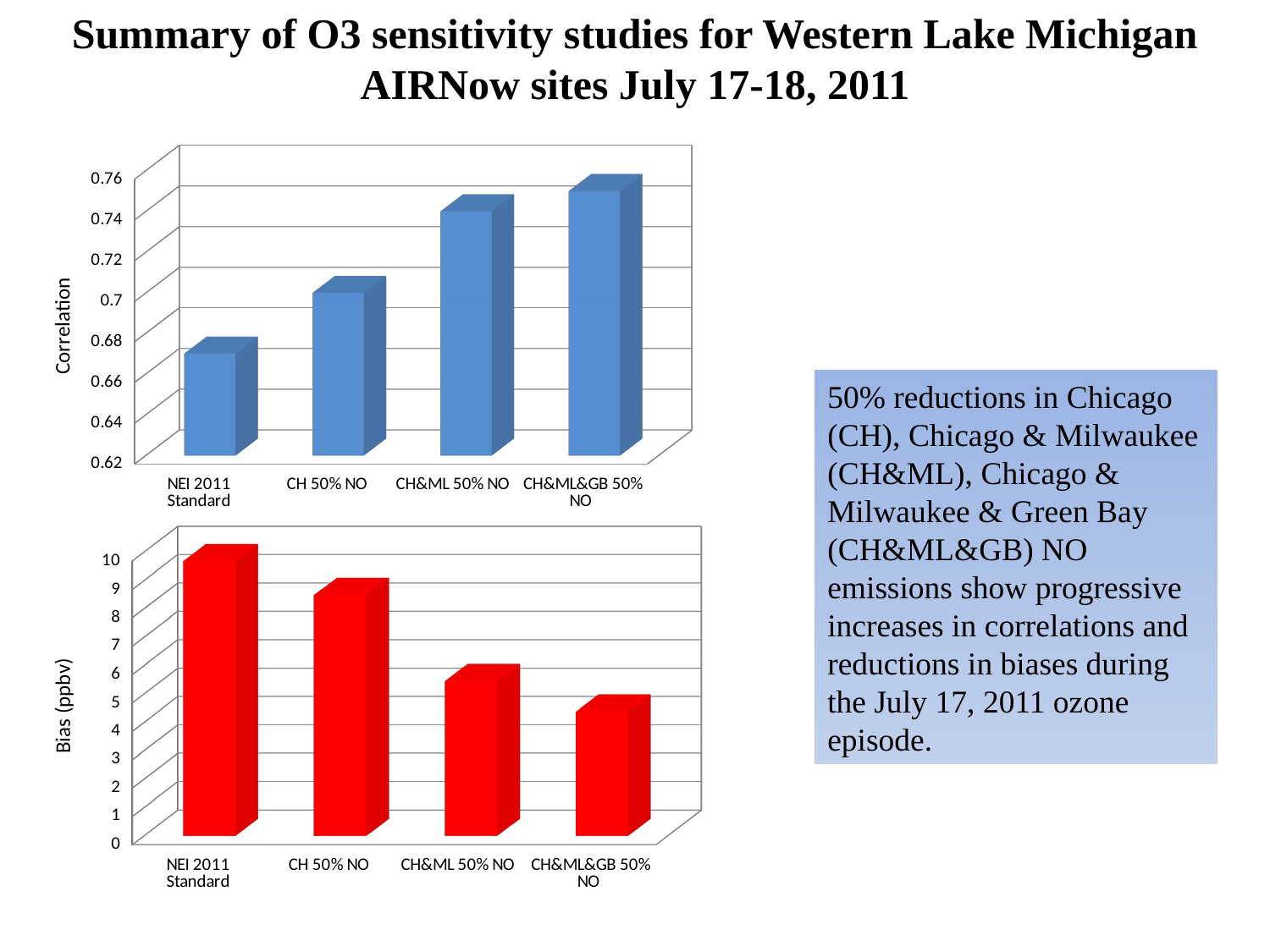
What kind of chart is the top chart with the Correlation axis? bar chart In the bottom Bias (ppbv) chart, which category has the lowest bias? CH&ML&GB 50% NO In the top Correlation chart, which category has the highest correlation? CH&ML&GB 50% NO In the bottom Bias (ppbv) chart, which is larger, the bias for CH 50% NO or for CH&ML 50% NO? CH 50% NO In the top Correlation chart, which category has the lowest correlation? NEI 2011 Standard In the top Correlation chart, how many categories are shown on the x axis? 4 In the top Correlation chart, is the value for CH&ML 50% NO greater or less than 0.72? greater In the bottom Bias (ppbv) chart, is the value for NEI 2011 Standard greater or less than 9? greater In the top Correlation chart, is the value for NEI 2011 Standard greater or less than 0.68? less In the top Correlation chart, do the values rise or fall from left to right along the x axis? rise In the bottom Bias (ppbv) chart, which category has the highest bias? NEI 2011 Standard In the bottom Bias (ppbv) chart, do the values rise or fall from left to right along the x axis? fall